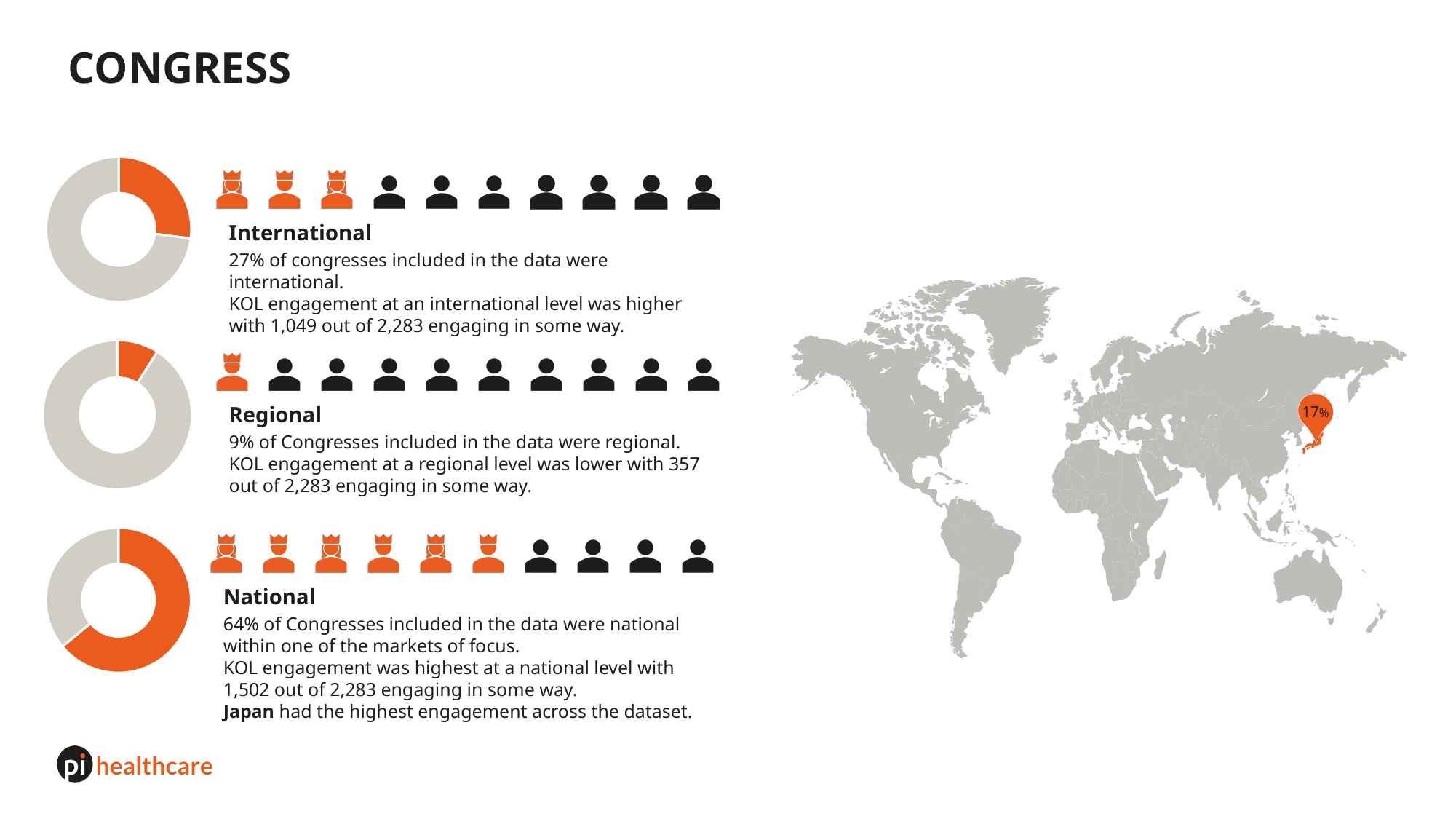
According to the slide, what percentage of congresses included in the data were regional? 9% How many KOLs engaged at a regional level out of 2,283? 357 According to the slide, what percentage of congresses included in the data were national? 64% How many KOLs engaged at an international level out of 2,283? 1,049 According to the slide, what percentage of congresses included in the data were international? 27% What percentage is shown on the map marker over Japan? 17% Which congress level has the smallest share of congresses in the data? Regional How many donut charts are shown on the slide? 3 What kind of chart is used to show the share of congresses that were international, regional and national? Donut chart Which is larger, the share of international congresses or the share of regional congresses? International Which congress level has the largest share of congresses in the data? National What is the difference in percentage points between the share of national congresses and the share of international congresses? 37